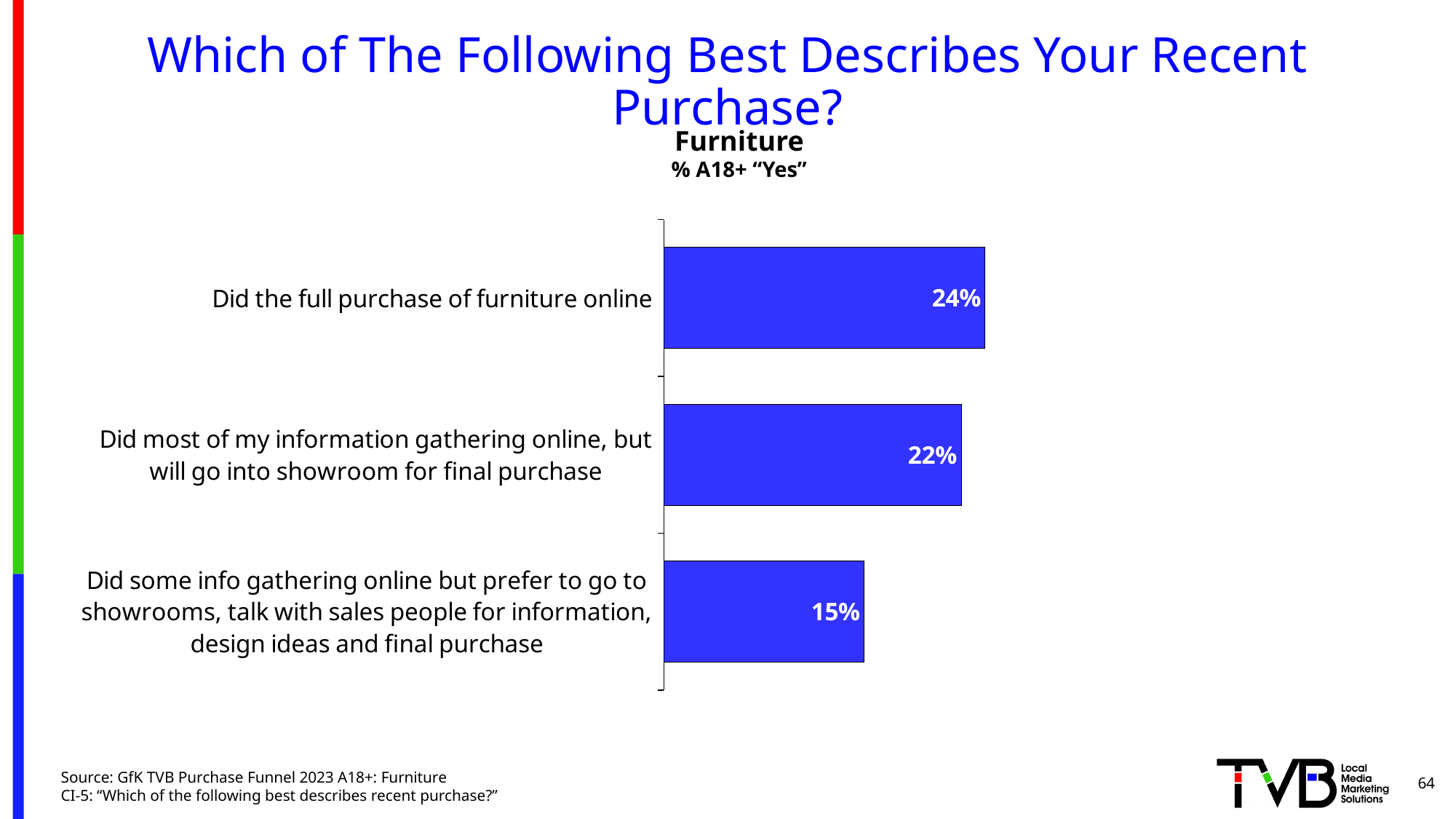
Which category has the highest value? Did the full purchase of furniture online What is the value for 'Did most of my information gathering online, but will go into showroom for final purchase'? 22% What percentage of A18+ said they did the full purchase of furniture online? 24% What is the title of the chart? Furniture Which is larger: the value for 'Did most of my information gathering online, but will go into showroom for final purchase' or the value for 'Did some info gathering online but prefer to go to showrooms...'? Did most of my information gathering online, but will go into showroom for final purchase Which category has the lowest value? Did some info gathering online but prefer to go to showrooms, talk with sales people for information, design ideas and final purchase What is the difference between the highest and lowest values on the chart? 9% What is the difference between the value for 'Did the full purchase of furniture online' and 'Did most of my information gathering online, but will go into showroom for final purchase'? 2% What kind of chart is shown on the slide? Bar chart What percentage did some info gathering online but prefer to go to showrooms, talk with sales people for information, design ideas and final purchase? 15% How many categories are shown on the chart? 3 What colour are the bars in the chart? Blue